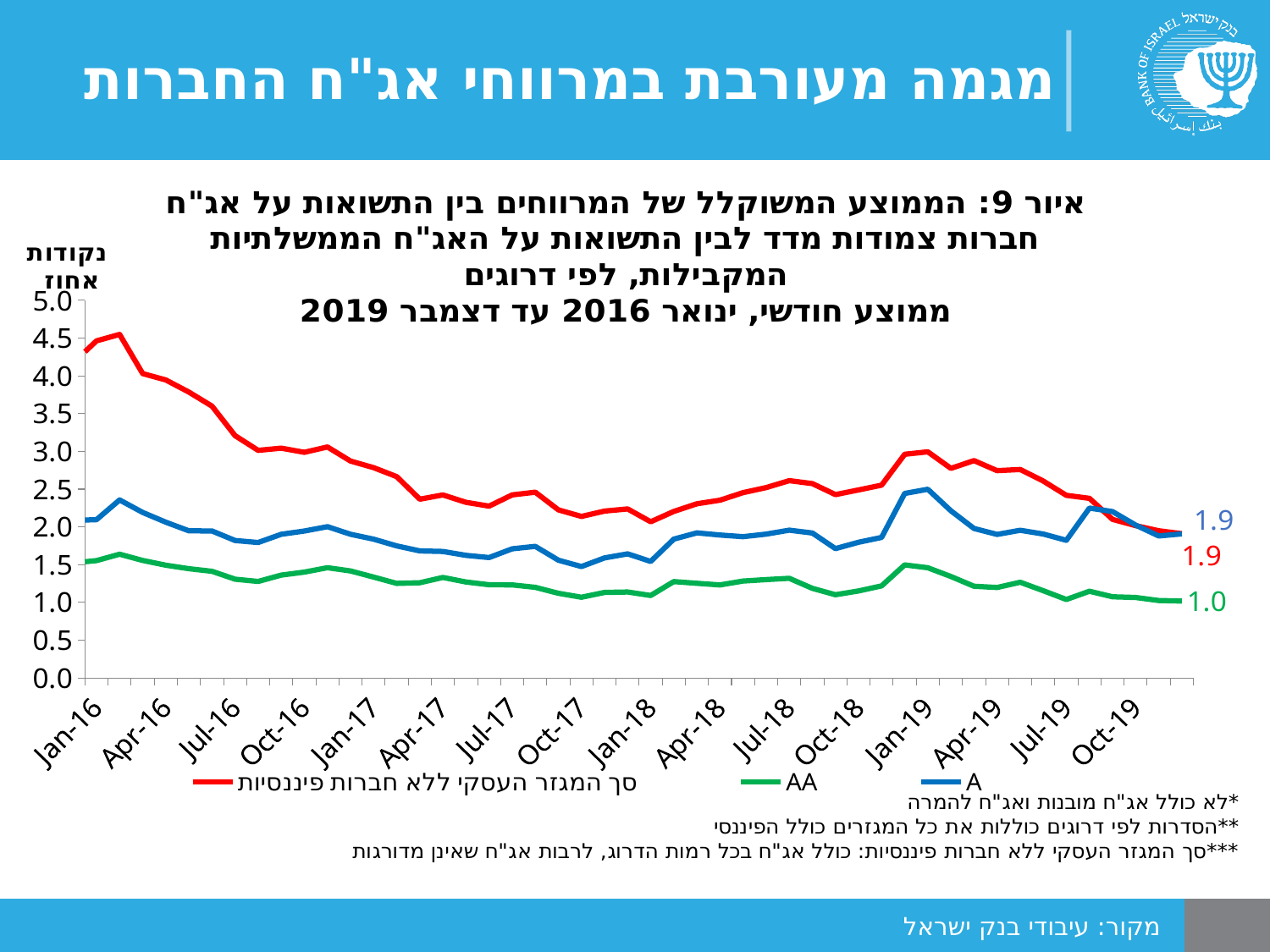
Which series has the highest value at Jan-16? סך המגזר העסקי ללא חברות פיננסיות Does the סך המגזר העסקי ללא חברות פיננסיות line overall rise or fall from Jan-16 to the end of 2019? fall What is the final value labelled at the end of the AA line? 1.0 What is the difference between the final labelled values of the A line and the AA line? 0.9 Is the value of the סך המגזר העסקי ללא חברות פיננסיות line at Jan-19 greater or less than 2.5? greater What colour is the AA line in the legend? green What kind of chart is shown on the slide? line chart What is the final value labelled at the end of the A line? 1.9 Is the value of the סך המגזר העסקי ללא חברות פיננסיות line at Jan-16 greater or less than 4.0? greater What is the final value labelled at the end of the line for סך המגזר העסקי ללא חברות פיננסיות? 1.9 How many series does the legend list? 3 Is the value of the AA line at Jan-16 greater or less than 2.0? less